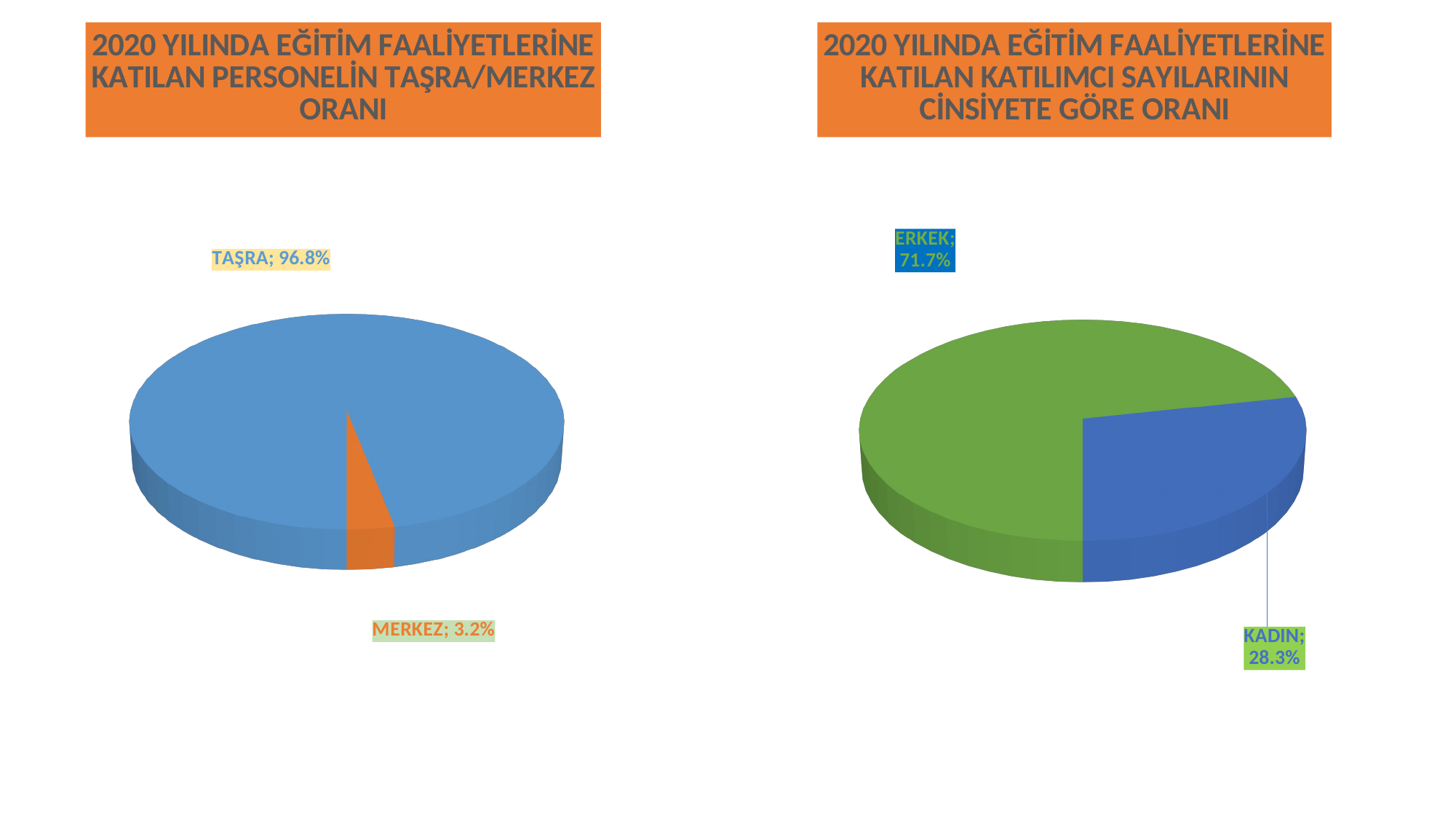
In the left chart (TAŞRA/MERKEZ ORANI), what is the difference between the TAŞRA and MERKEZ shares? 93.6% In the right chart (CİNSİYETE GÖRE ORANI), what is the value for ERKEK? 71.7% In the left chart (TAŞRA/MERKEZ ORANI), which category has the largest share? TAŞRA How many slices does the left chart (TAŞRA/MERKEZ ORANI) have? 2 In the right chart (CİNSİYETE GÖRE ORANI), what is the value for KADIN? 28.3% In the right chart (CİNSİYETE GÖRE ORANI), which is larger, ERKEK or KADIN? ERKEK What kind of chart is the right chart (CİNSİYETE GÖRE ORANI)? Pie chart In the left chart (TAŞRA/MERKEZ ORANI), what is the value for MERKEZ? 3.2% In the right chart (CİNSİYETE GÖRE ORANI), which category has the smallest share? KADIN In the left chart (TAŞRA/MERKEZ ORANI), what is the value for TAŞRA? 96.8% In the right chart (CİNSİYETE GÖRE ORANI), what colour is the ERKEK slice? Green In the right chart (CİNSİYETE GÖRE ORANI), what is the difference between the ERKEK and KADIN shares? 43.4%